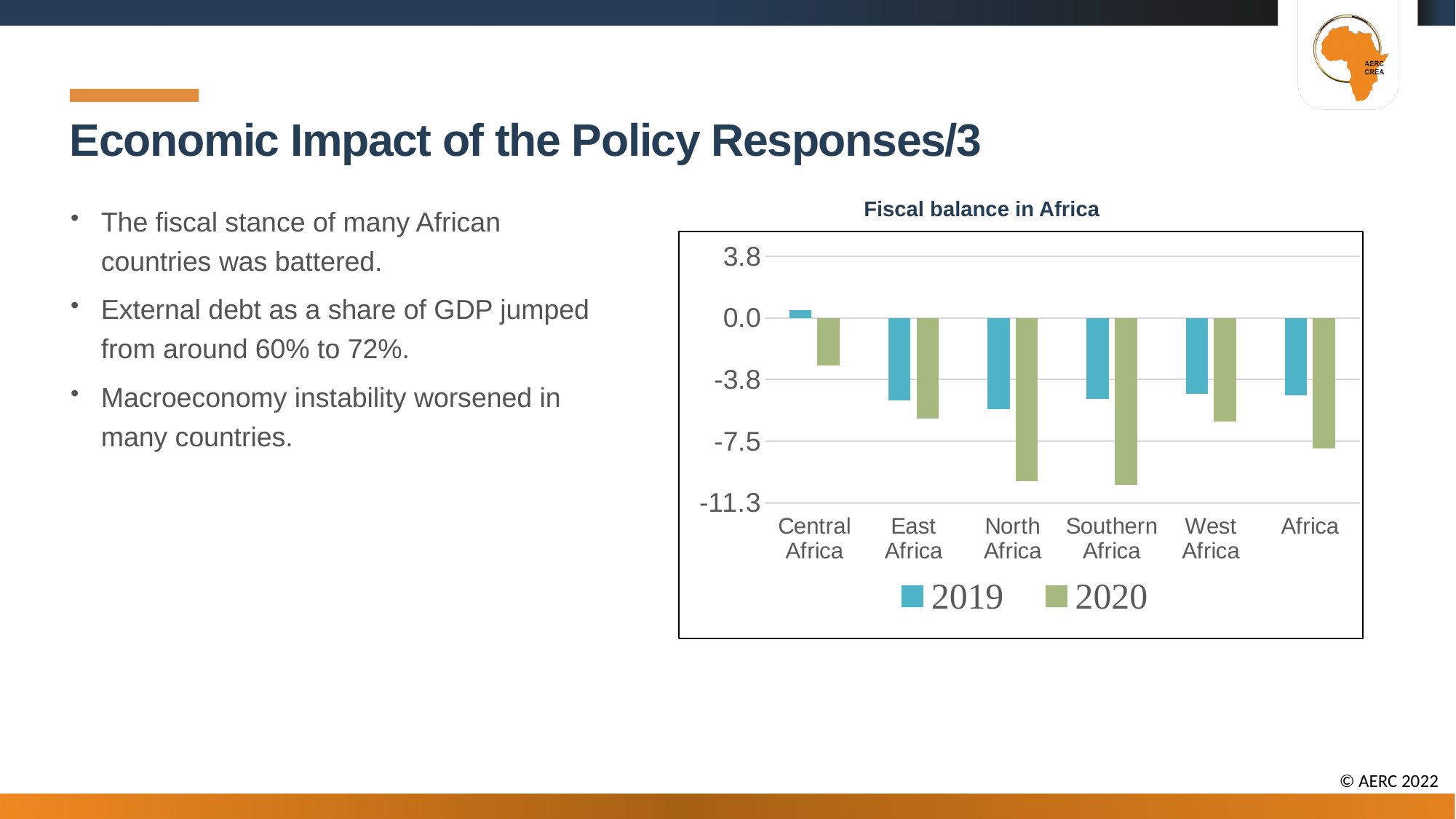
Which colour represents the 2020 series in the chart? green What is the title of the chart? Fiscal balance in Africa Is the 2019 value for East Africa greater or less than -3.8? less How many series does the chart's legend list? 2 What kind of chart is shown on the slide? bar chart How many categories are shown on the x axis of the chart? 6 Is the 2020 value for Central Africa greater or less than -3.8? greater Which category and series has the highest value in the chart? Central Africa, 2019 Is the 2020 value for West Africa greater or less than -7.5? greater Which region has the lowest 2019 value in the chart? North Africa For Central Africa, which is larger: the 2019 value or the 2020 value? 2019